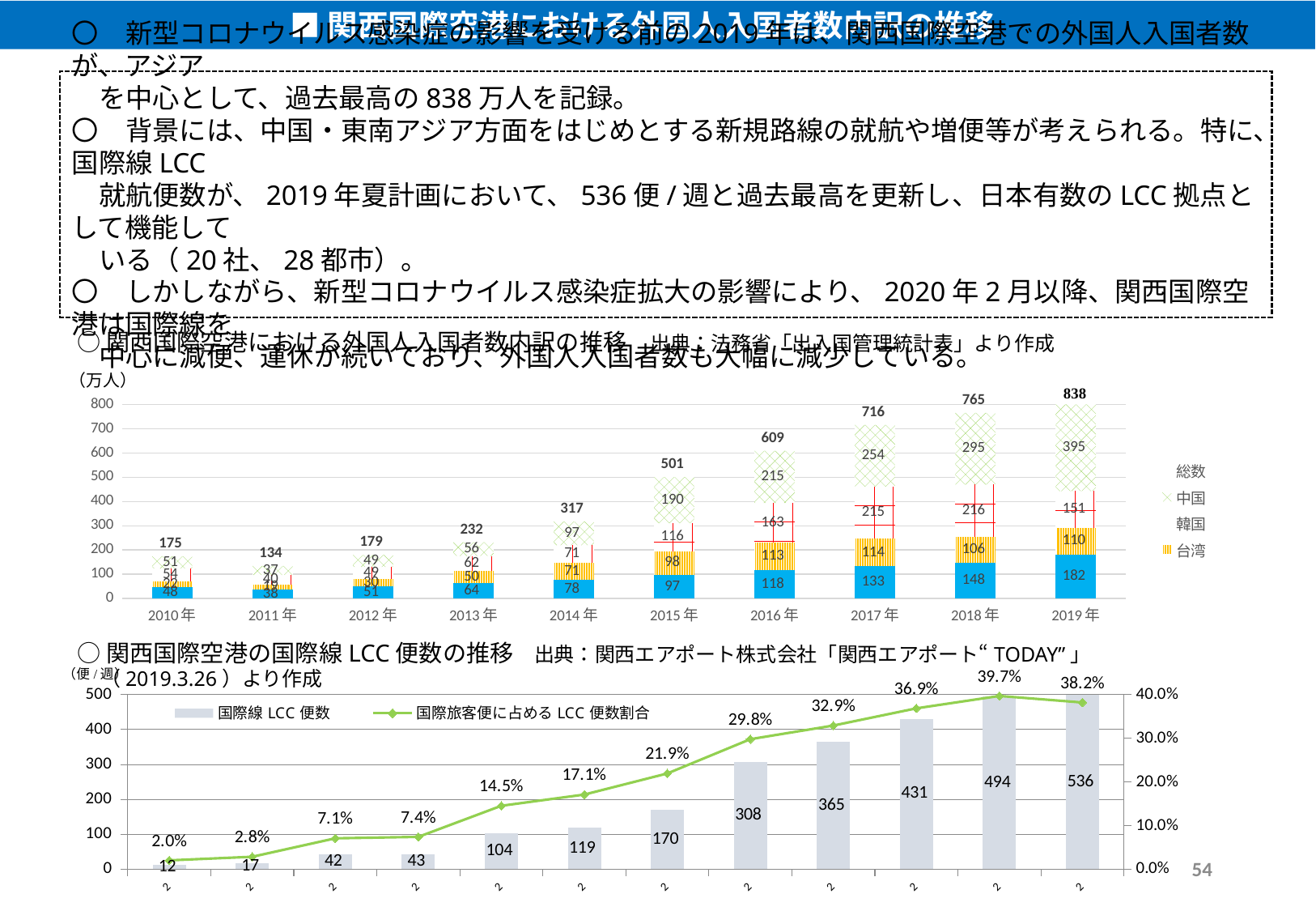
In the top chart, which year has the lowest total number of foreign entrants? 2011年 In the top chart (関西国際空港における外国人入国者数内訳の推移), what is the total (総数) for 2019年? 838 In the bottom chart, what is the highest value of 国際旅客便に占めるLCC便数割合? 39.7% In the top chart, how many years are shown on the x axis? 10 In the top chart, which year has the highest total number of foreign entrants? 2019年 In the top chart, how many entries does the legend list? 4 In the bottom chart, what is the value of the first (leftmost) bar? 12 In the bottom chart, do the 国際線LCC便数 values generally rise or fall from left to right? rise In the top chart, what is the value for 韓国 in 2017年? 215 In the top chart, what is the difference between the totals for 2019年 and 2018年? 73 In the top chart, what is the value for 中国 in 2019年? 395 In the bottom chart (関西国際空港の国際線LCC便数の推移), what is the highest value of 国際線LCC便数? 536